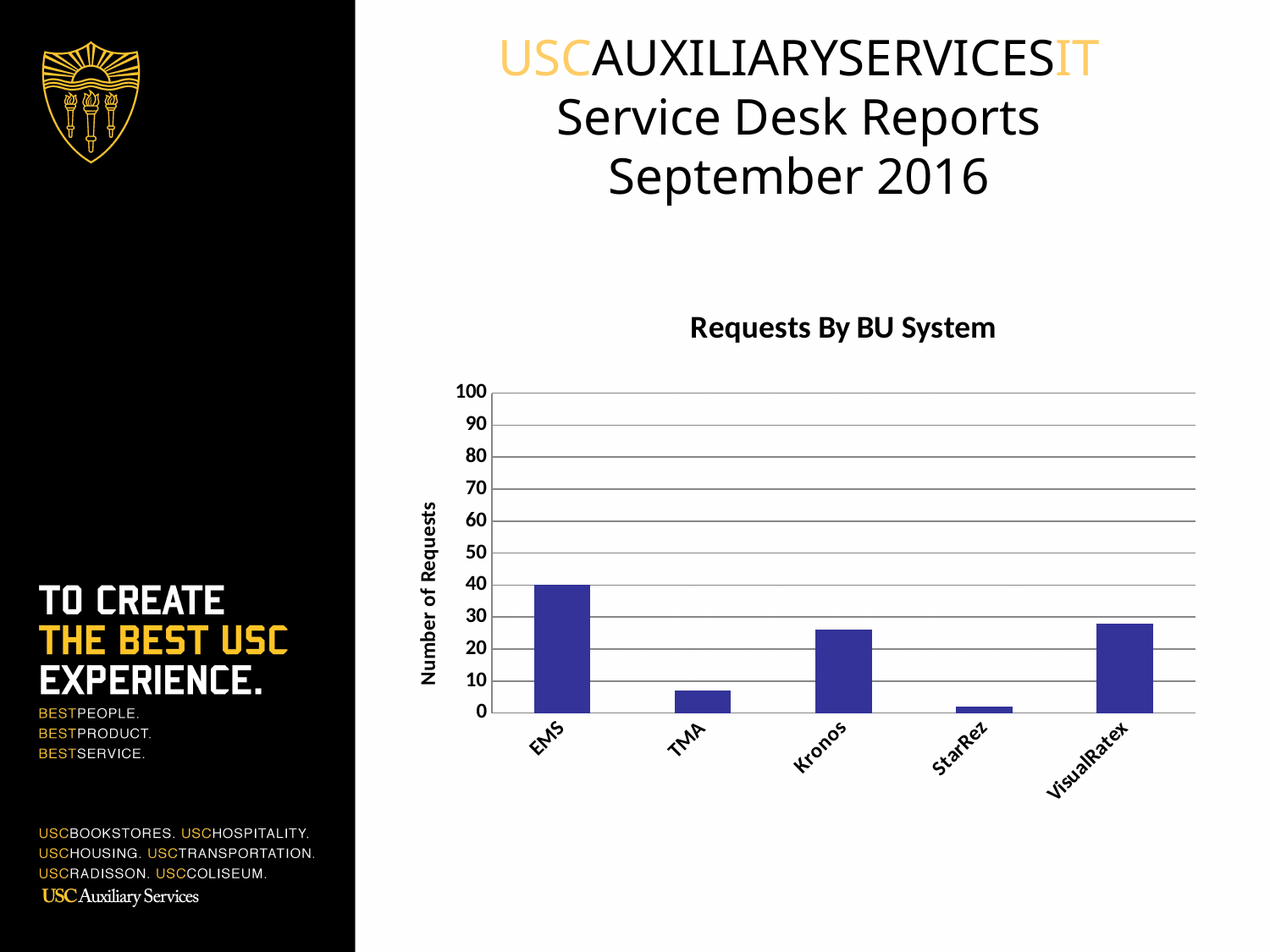
What is the number of requests for EMS? 40 What is the title of the chart? Requests By BU System Which has more requests, TMA or StarRez? TMA What type of chart is shown on the slide? bar chart Which BU system has the lowest number of requests? StarRez Is the number of requests for VisualRatex greater or less than 30? less Which BU system has the highest number of requests? EMS Is the number of requests for Kronos greater or less than 20? greater Which has more requests, EMS or Kronos? EMS Is the number of requests for TMA greater or less than 10? less How many BU systems are shown on the x axis of the chart? 5 What is the label of the vertical axis of the chart? Number of Requests